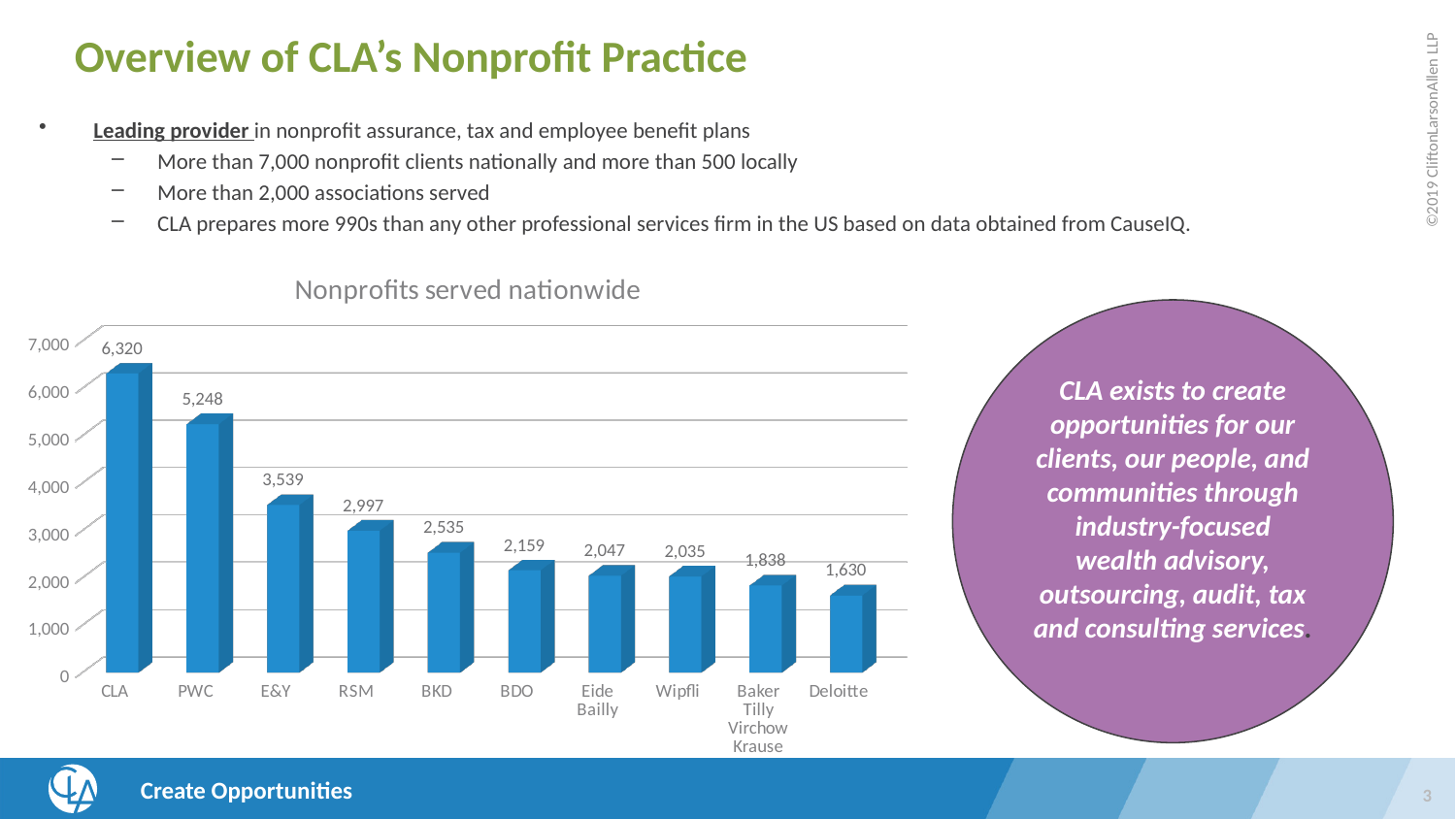
Which is larger, the value for E&Y or the value for BKD? E&Y What is the value for CLA in the Nonprofits served nationwide chart? 6,320 How many firms are shown in the chart? 10 Do the values rise or fall moving from left to right across the chart? Fall How many nonprofits does RSM serve according to the chart? 2,997 What is the title of the chart? Nonprofits served nationwide Is the value for BDO greater or less than 3,000? less What is the difference between the values for CLA and PWC? 1,072 What is the value shown for Deloitte? 1,630 What kind of chart is used to show nonprofits served nationwide? Bar chart Which firm has the highest number of nonprofits served? CLA Which firm has the lowest number of nonprofits served? Deloitte